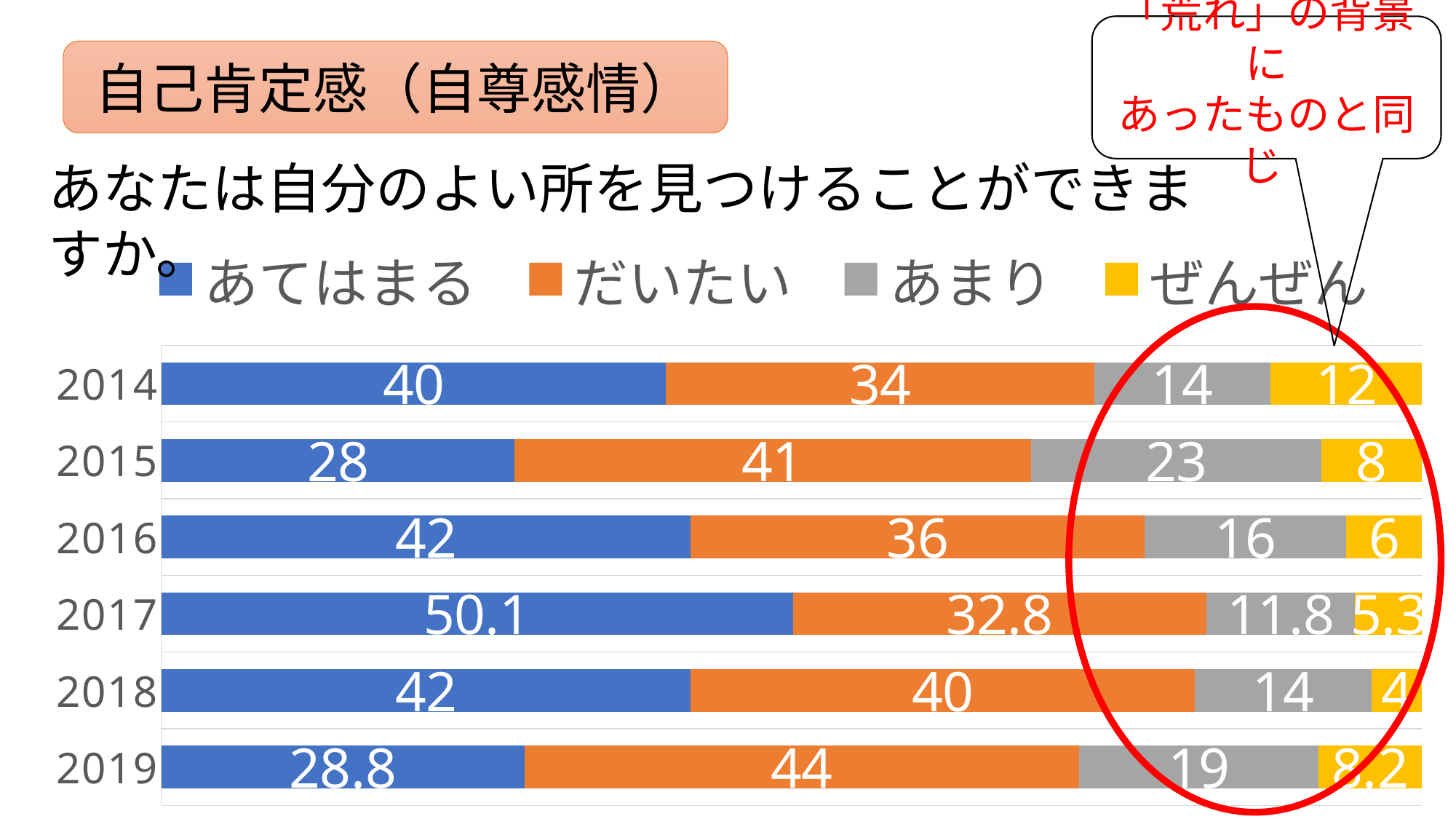
How many years are shown on the chart? 6 Which is larger, the だいたい value for 2018 or for 2016? 2018 What is the value for あてはまる in 2017? 50.1 What is the value for あまり in 2015? 23 Which year has the highest value for あてはまる? 2017 What is the total of the stacked bar for 2014? 100 How many series does the legend list? 4 What is the value for だいたい in 2019? 44 What kind of chart is shown on the slide? Stacked bar chart Which year has the lowest value for ぜんぜん? 2018 What is the value for ぜんぜん in 2014? 12 What is the difference between the あてはまる values for 2016 and 2015? 14